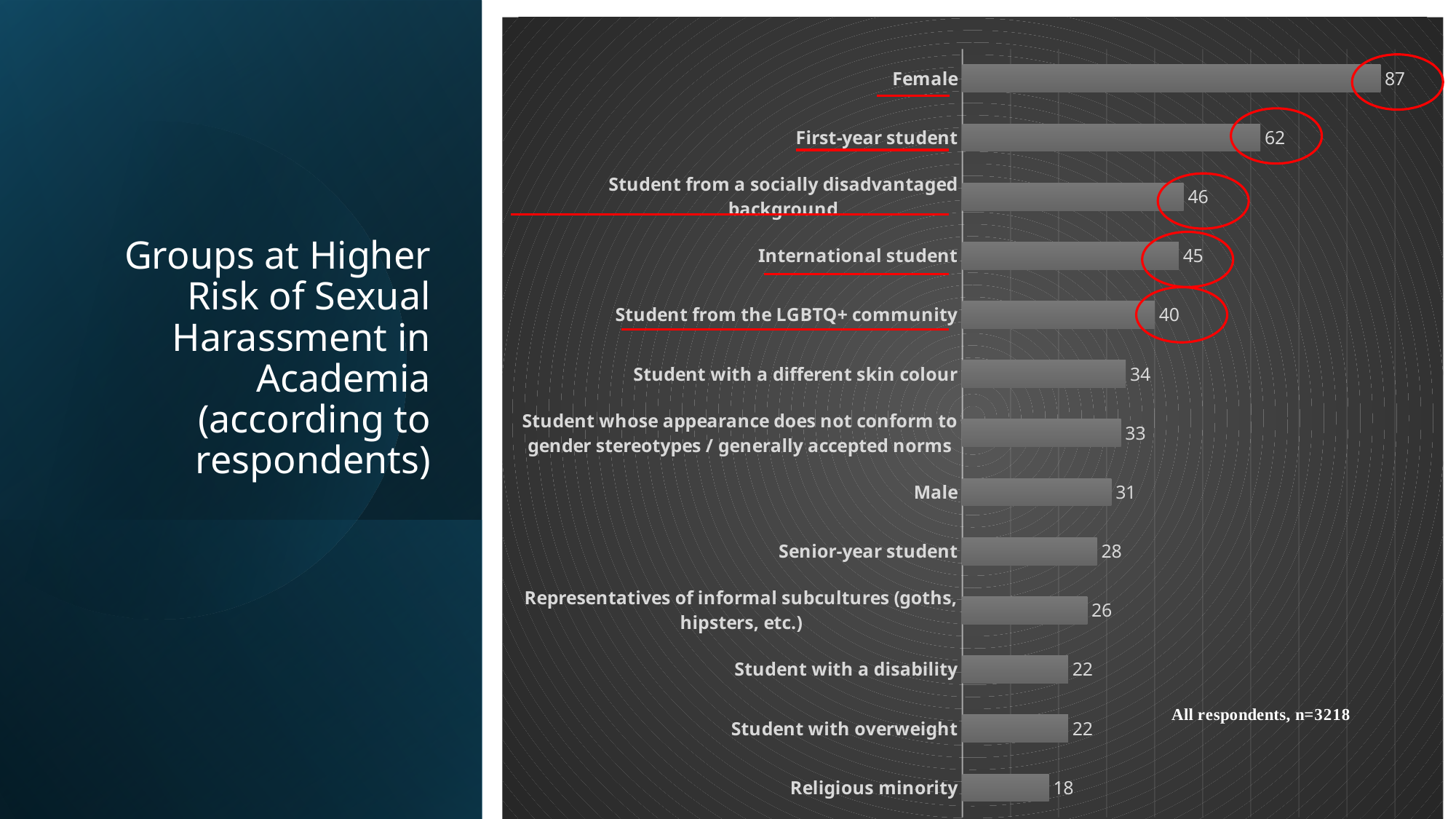
Which is larger, the value for Student from the LGBTQ+ community or the value for Student with a different skin colour? Student from the LGBTQ+ community What is the value for First-year student? 62 What is the value for Female? 87 What is the value for International student? 45 How many groups are shown in the chart? 13 What is the number of respondents stated on the chart? n=3218 What kind of chart is shown on the slide? Bar chart Which group has the highest value? Female Which group has the lowest value? Religious minority What is the difference between the values for Male and Senior-year student? 3 What is the difference between the values for Female and First-year student? 25 What is the value for Religious minority? 18